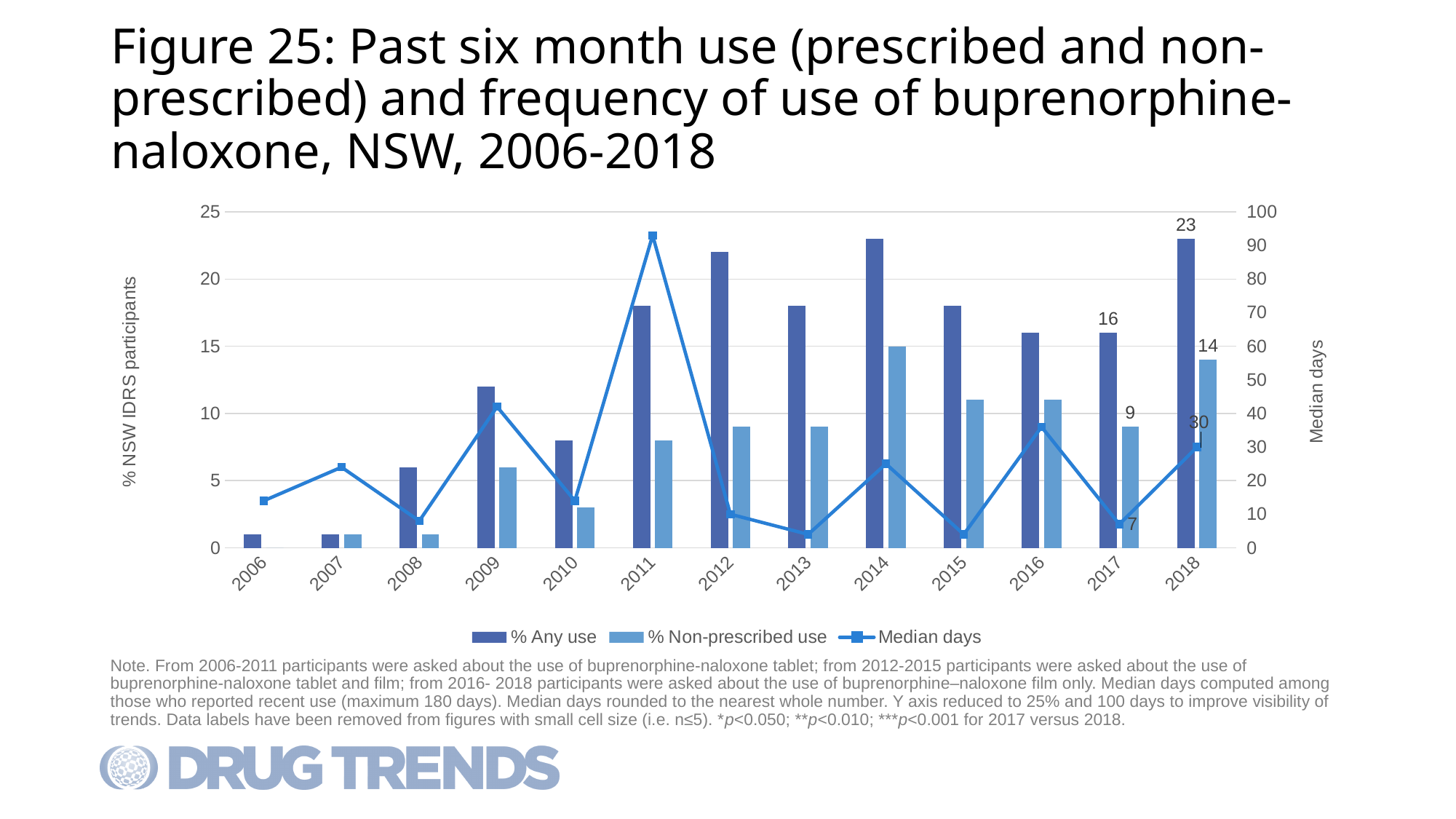
By how much did % Any use increase from 2017 to 2018? 7 What is the Median days value for 2017? 7 What is the % Any use value for 2018? 23 Which year has the higher % Any use, 2017 or 2018? 2018 What is the Median days value for 2018? 30 What is the % Non-prescribed use value for 2017? 9 What is the difference in % Non-prescribed use between 2018 and 2017? 5 Which year has the highest Median days value? 2011 Is the Median days value for 2011 greater or less than 80? greater What is the difference in Median days between 2018 and 2017? 23 How many years are shown on the x axis? 13 Is the % Any use value for 2012 greater or less than 20? greater